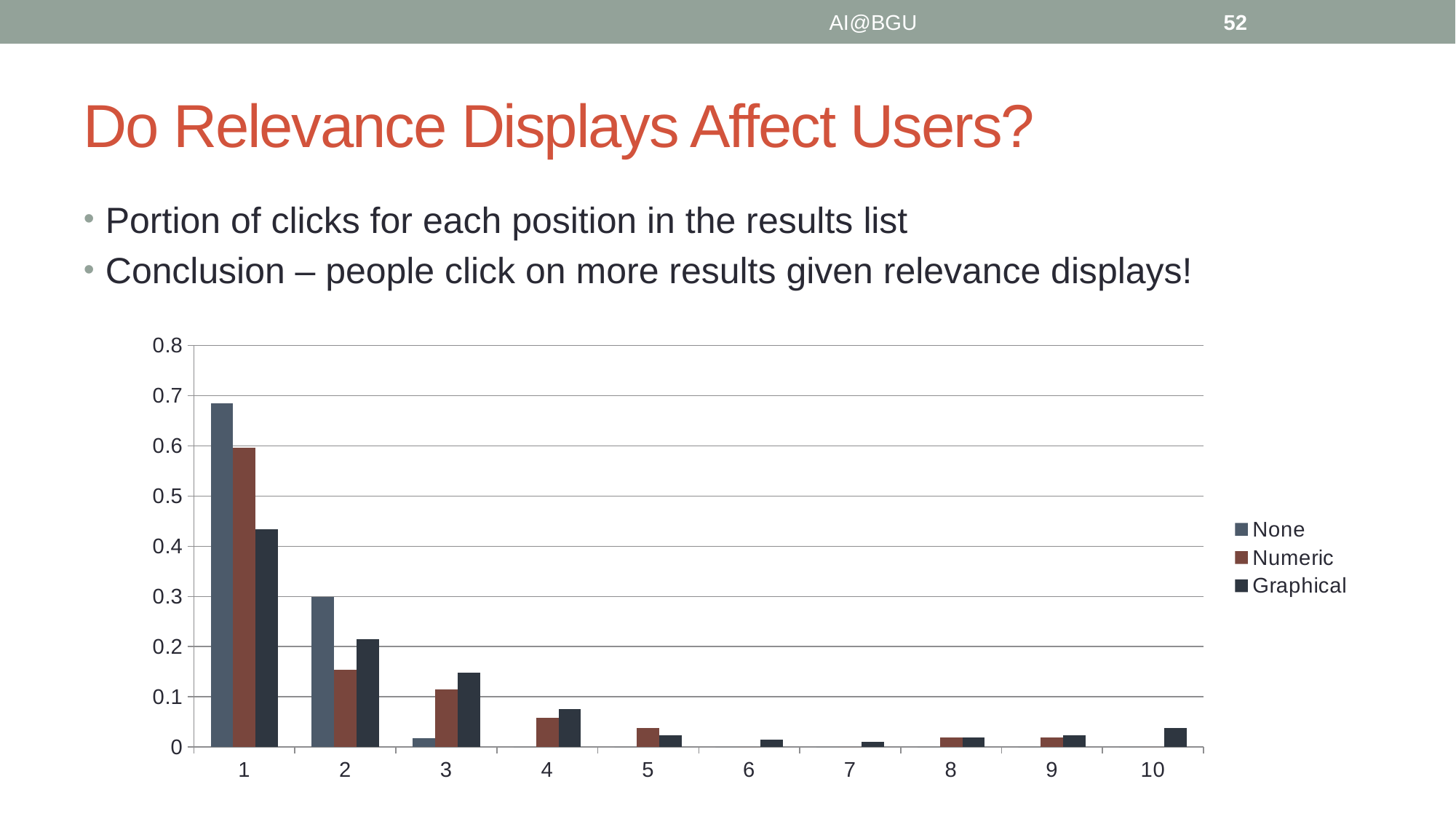
Do the values for the None series rise or fall as the position increases from 1 to 3? fall At position 2, which is larger: None or Graphical? None Is the value for None at position 1 greater or less than 0.6? greater Which series has the highest value at position 1? None Which series has the lowest value at position 3? None At position 3, which is larger: Numeric or Graphical? Graphical Is the value for Graphical at position 1 greater or less than 0.5? less Is the value for None at position 2 greater or less than 0.2? greater How many positions are shown along the x axis? 10 What kind of chart is shown on the slide? Bar chart What are the three entries in the legend? None, Numeric, Graphical How many series does the legend list? 3